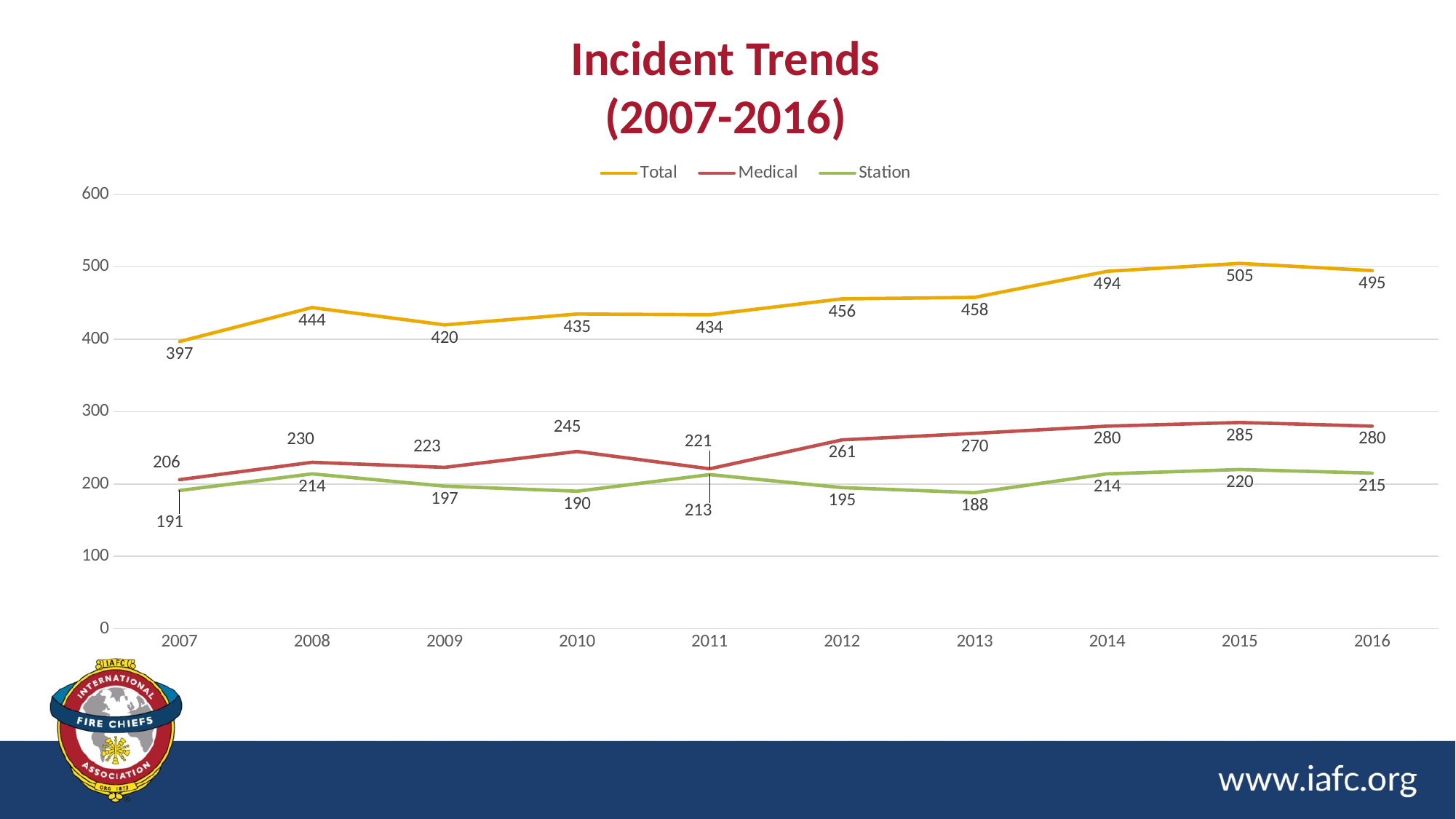
In which year is the Total series at its highest? 2015 Which colour is used for the Total series? Orange What is the difference between the Total values for 2016 and 2007? 98 What is the Station value for 2013? 188 Is the Total value for 2014 greater or less than 400? greater How many years are plotted along the x axis? 10 What is the Medical value for 2010? 245 How many series does the legend list? 3 What is the Total value for 2015? 505 What kind of chart is shown on the slide? Line chart In which year is the Station series at its lowest? 2013 Which is larger, the Medical value for 2012 or the Medical value for 2011? 2012